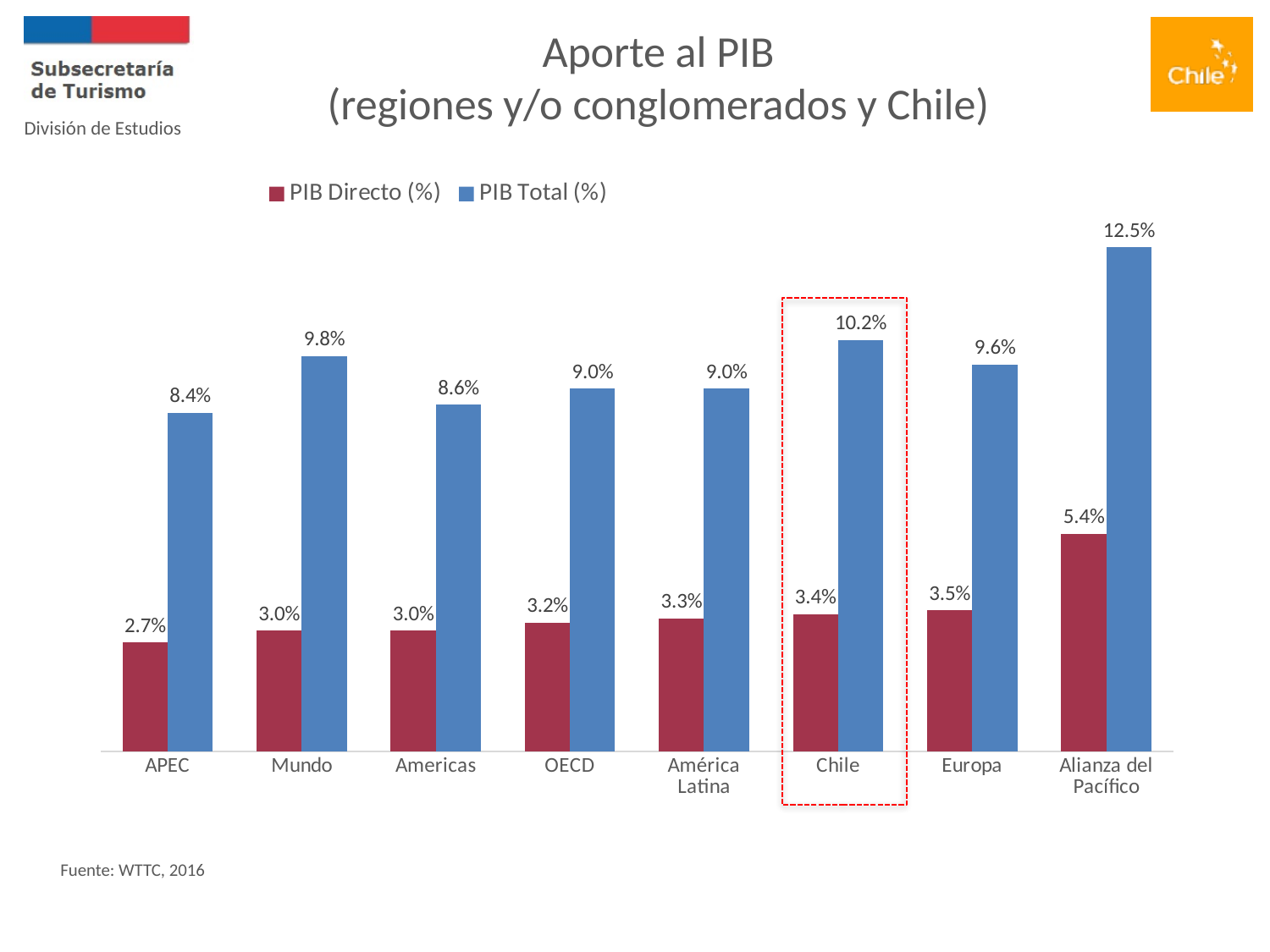
What is the PIB Directo (%) value for APEC? 2.7% Which category has the highest PIB Total (%)? Alianza del Pacífico Which is larger, the PIB Total (%) for Mundo or for Europa? Mundo Which category has the lowest PIB Directo (%)? APEC How many series does the legend list? 2 What is the difference between the PIB Total (%) for Alianza del Pacífico and for Chile? 2.3% What is the PIB Total (%) value for Alianza del Pacífico? 12.5% Which category is highlighted with a red dashed box? Chile What is the difference between PIB Total (%) and PIB Directo (%) for Chile? 6.8% What kind of chart is shown on the slide? Bar chart What is the PIB Total (%) value for Chile? 10.2% How many categories are shown on the x axis? 8